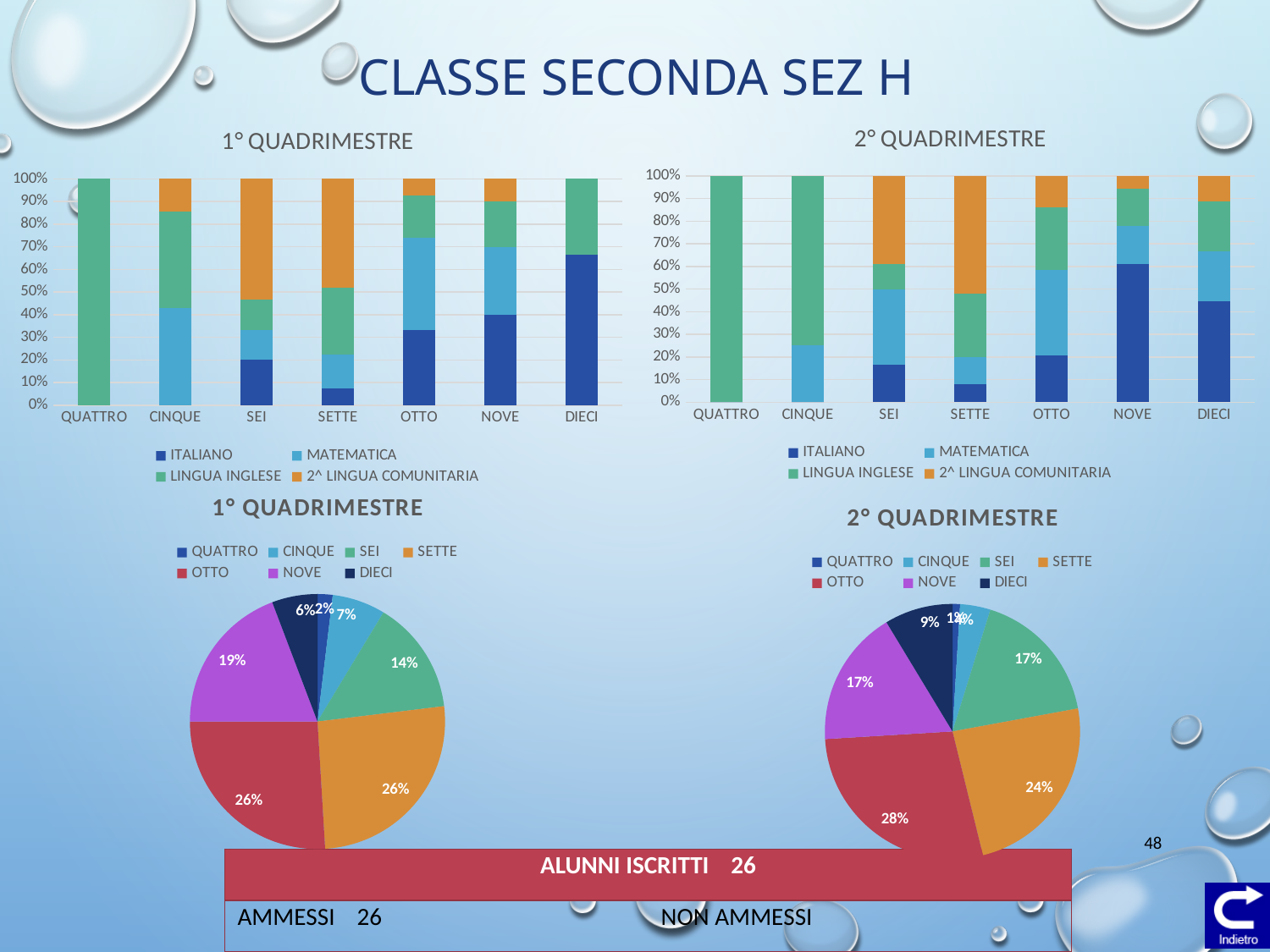
In the top-left 1° QUADRIMESTRE bar chart, how many series does the legend list? 4 In the top-right 2° QUADRIMESTRE bar chart, is the ITALIANO share for NOVE greater or less than 50%? greater In the top-left 1° QUADRIMESTRE bar chart, is the ITALIANO share for DIECI greater or less than 50%? greater What kind of chart is the top-left chart titled 1° QUADRIMESTRE? Stacked bar chart In the bottom-right 2° QUADRIMESTRE pie chart, what is the value for SEI? 17% In the bottom-left 1° QUADRIMESTRE pie chart, what share does SETTE have? 26% In the bottom-left 1° QUADRIMESTRE pie chart, which category has the smallest slice? QUATTRO In the bottom-left 1° QUADRIMESTRE pie chart, which is larger, SEI or NOVE? NOVE In the bottom-left 1° QUADRIMESTRE pie chart, what is the value for NOVE? 19% In the bottom-right 2° QUADRIMESTRE pie chart, which category has the largest slice? OTTO In the bottom-right 2° QUADRIMESTRE pie chart, what is the difference between the OTTO and SETTE shares? 4% In the top-right 2° QUADRIMESTRE bar chart, how many categories are shown on the x axis? 7